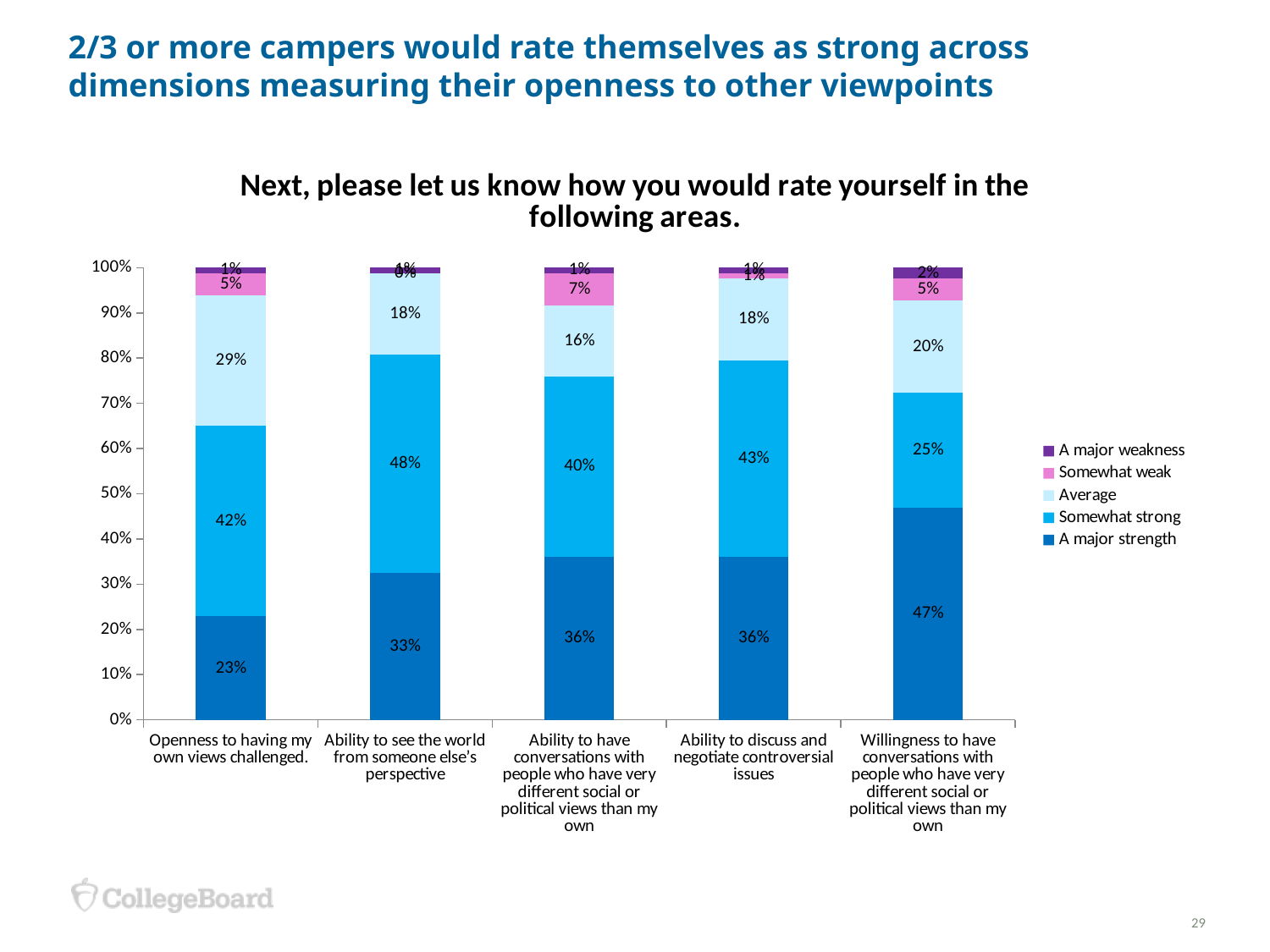
What is the 'Somewhat weak' value for 'Ability to have conversations with people who have very different social or political views than my own'? 7% What percentage of campers rated 'Openness to having my own views challenged' as a major strength? 23% What is the 'Somewhat strong' value for 'Ability to see the world from someone else's perspective'? 48% Which category has the lowest 'A major strength' value? Openness to having my own views challenged How many categories are shown on the x axis? 5 What is the difference between the 'Somewhat strong' values for 'Ability to see the world from someone else's perspective' and 'Willingness to have conversations with people who have very different social or political views than my own'? 23% Which category has the highest 'A major strength' value? Willingness to have conversations with people who have very different social or political views than my own How many series does the legend list? 5 What kind of chart is shown on the slide? Stacked bar chart What is the combined 'A major strength' and 'Somewhat strong' share for 'Willingness to have conversations with people who have very different social or political views than my own'? 72% Which is larger: the 'Average' value for 'Openness to having my own views challenged' or for 'Ability to discuss and negotiate controversial issues'? Openness to having my own views challenged What is the 'Average' value for 'Willingness to have conversations with people who have very different social or political views than my own'? 20%